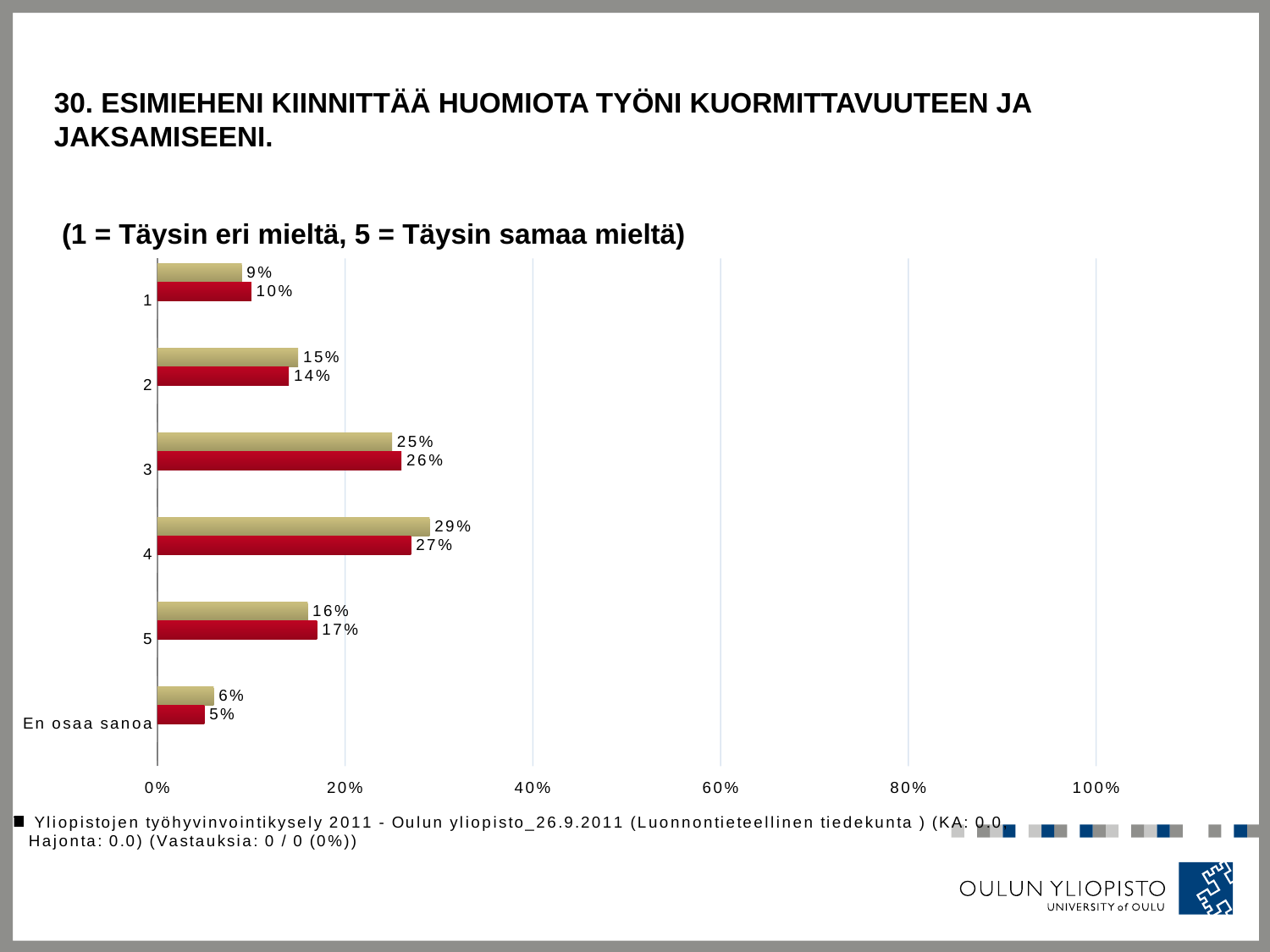
For category 5, which is larger: the tan (gold) bar or the red bar? the red bar What is the value of the tan (gold) bar for category 3? 25% What type of chart is shown on the slide? bar chart What is the highest value shown on the horizontal axis of the chart? 100% How many categories are shown on the vertical axis of the chart? 6 What is the value of the red bar for 'En osaa sanoa'? 5% Is the value of the red bar for category 3 greater or less than 20%? greater What is the difference between the tan (gold) bar and the red bar for category 4? 2% Which category has the highest value for the tan (gold) bars? 4 Which category has the lowest value for the red bars? En osaa sanoa What is the value of the tan (gold) bar for category 1? 9% What is the value of the red bar for category 4? 27%